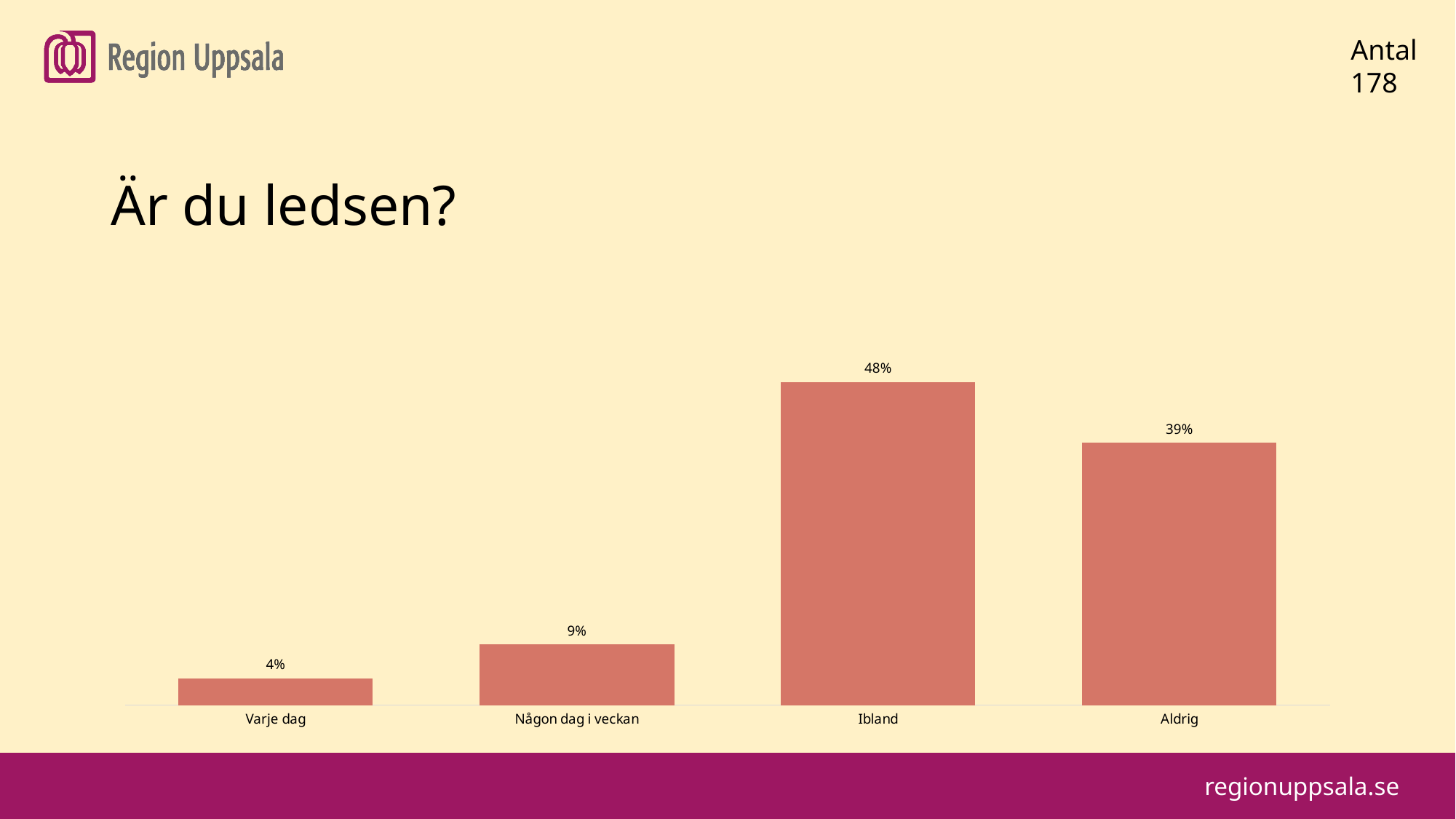
What is the difference between the values for Någon dag i veckan and Varje dag? 5% Which category has the highest value? Ibland Which is larger, the value for Aldrig or the value for Någon dag i veckan? Aldrig What is the value for Ibland? 48% What is the value for Någon dag i veckan? 9% What kind of chart is shown on the slide? Bar chart Which category has the lowest value? Varje dag What is the title of the slide containing the chart? Är du ledsen? What is the difference between the values for Ibland and Aldrig? 9% How many categories are shown in the chart? 4 What is the value for Aldrig? 39% What is the value for Varje dag? 4%